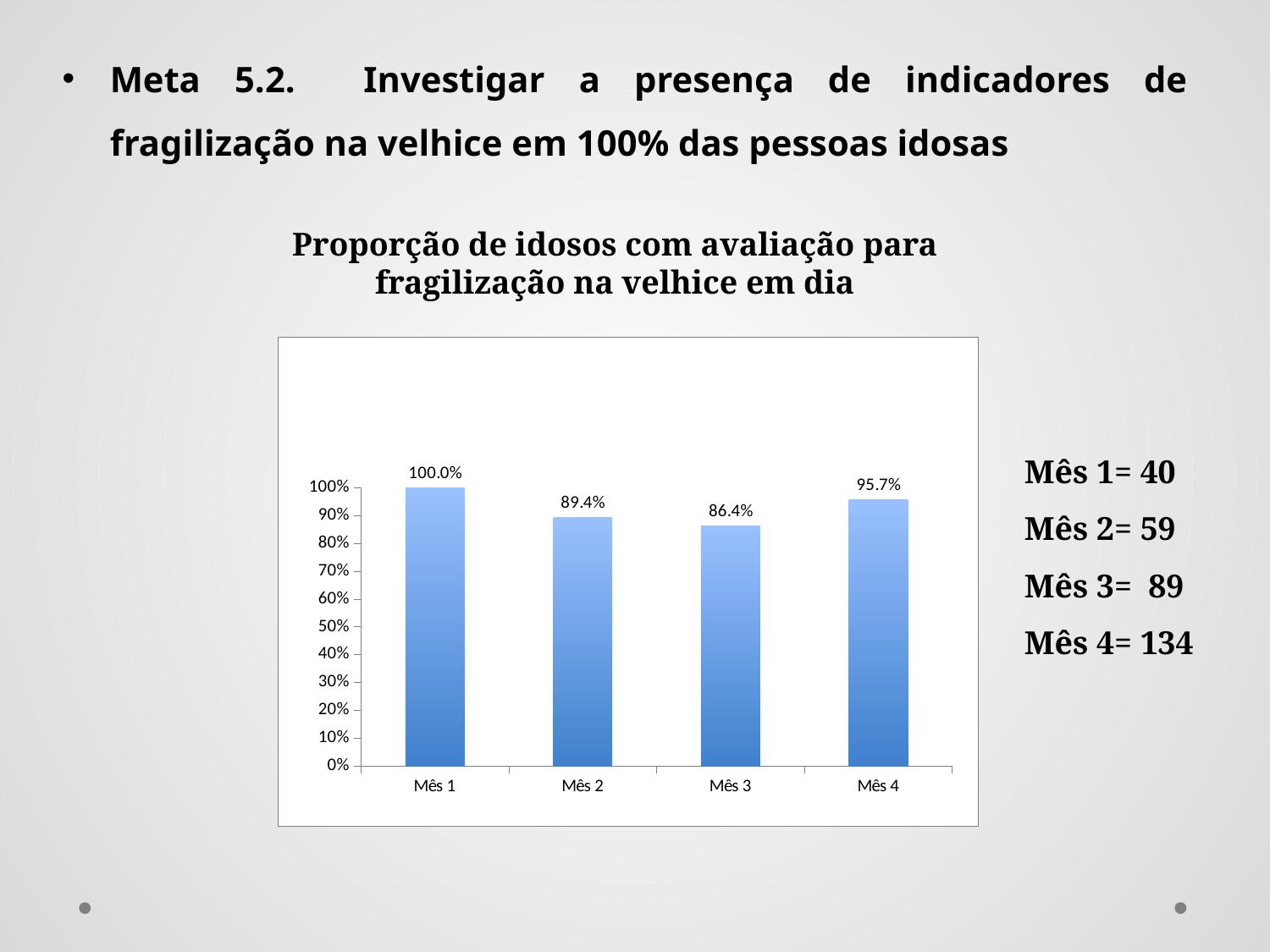
How many months are shown on the x axis? 4 What is the value for Mês 1? 100.0% What is the value for Mês 2? 89.4% What kind of chart is this? Bar chart What is the title of the chart? Proporção de idosos com avaliação para fragilização na velhice em dia Which month has the highest value? Mês 1 Which is larger, the value for Mês 2 or the value for Mês 4? Mês 4 Which month has the lowest value? Mês 3 What is the value for Mês 4? 95.7% What is the difference between the values for Mês 4 and Mês 2? 6.3% What is the difference between the values for Mês 1 and Mês 3? 13.6% What is the value for Mês 3? 86.4%